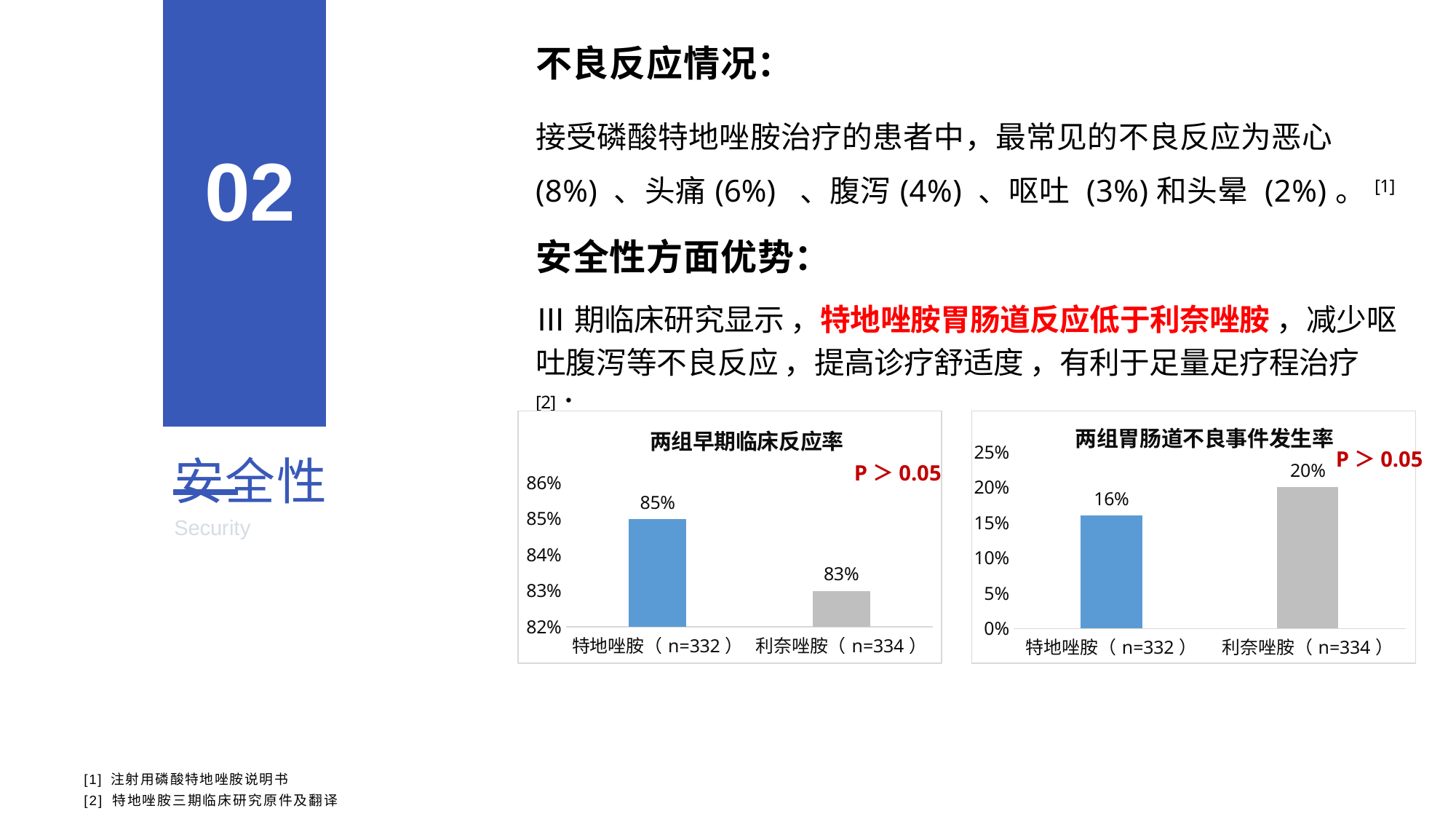
In the chart titled 两组早期临床反应率, which category has the highest value? 特地唑胺（n=332） In the chart titled 两组早期临床反应率, what is the difference between the values for 特地唑胺（n=332） and 利奈唑胺（n=334）? 2% In the chart titled 两组早期临床反应率, what is the value for 特地唑胺（n=332）? 85% In the chart titled 两组胃肠道不良事件发生率, is the value for 利奈唑胺（n=334） greater or less than 15%? greater In the chart titled 两组胃肠道不良事件发生率, what is the value for 利奈唑胺（n=334）? 20% What kind of chart is the chart titled 两组胃肠道不良事件发生率? bar chart How many categories are shown in the chart titled 两组早期临床反应率? 2 In the chart titled 两组胃肠道不良事件发生率, what is the value for 特地唑胺（n=332）? 16% In the chart titled 两组早期临床反应率, what is the value for 利奈唑胺（n=334）? 83% In the chart titled 两组胃肠道不良事件发生率, which category has the lowest value? 特地唑胺（n=332） In the chart titled 两组胃肠道不良事件发生率, which is larger, the value for 特地唑胺（n=332） or 利奈唑胺（n=334）? 利奈唑胺（n=334） In the chart titled 两组胃肠道不良事件发生率, what is the difference between the values for 利奈唑胺（n=334） and 特地唑胺（n=332）? 4%